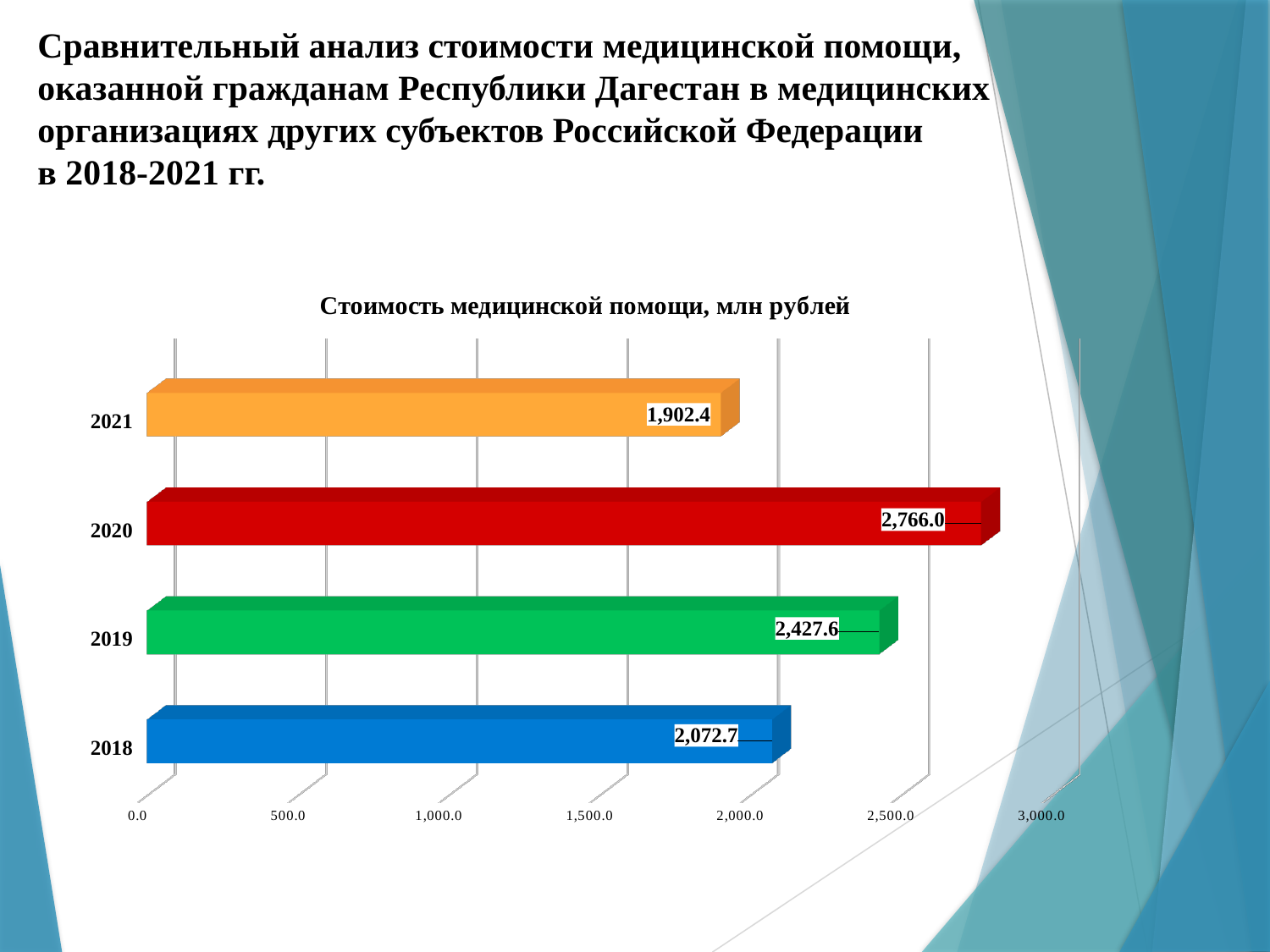
Which year has the highest value? 2020 What is the value for 2018? 2,072.7 Which year has the lowest value? 2021 How many years are shown in the chart? 4 What is the difference between the values for 2018 and 2021? 170.3 What kind of chart is this? bar chart Is the value for 2020 greater or less than 2,500.0? greater What is the value for 2019? 2,427.6 What is the value for 2021? 1,902.4 Which is larger, the value for 2019 or the value for 2018? 2019 What is the value for 2020? 2,766.0 What is the difference between the values for 2020 and 2019? 338.4